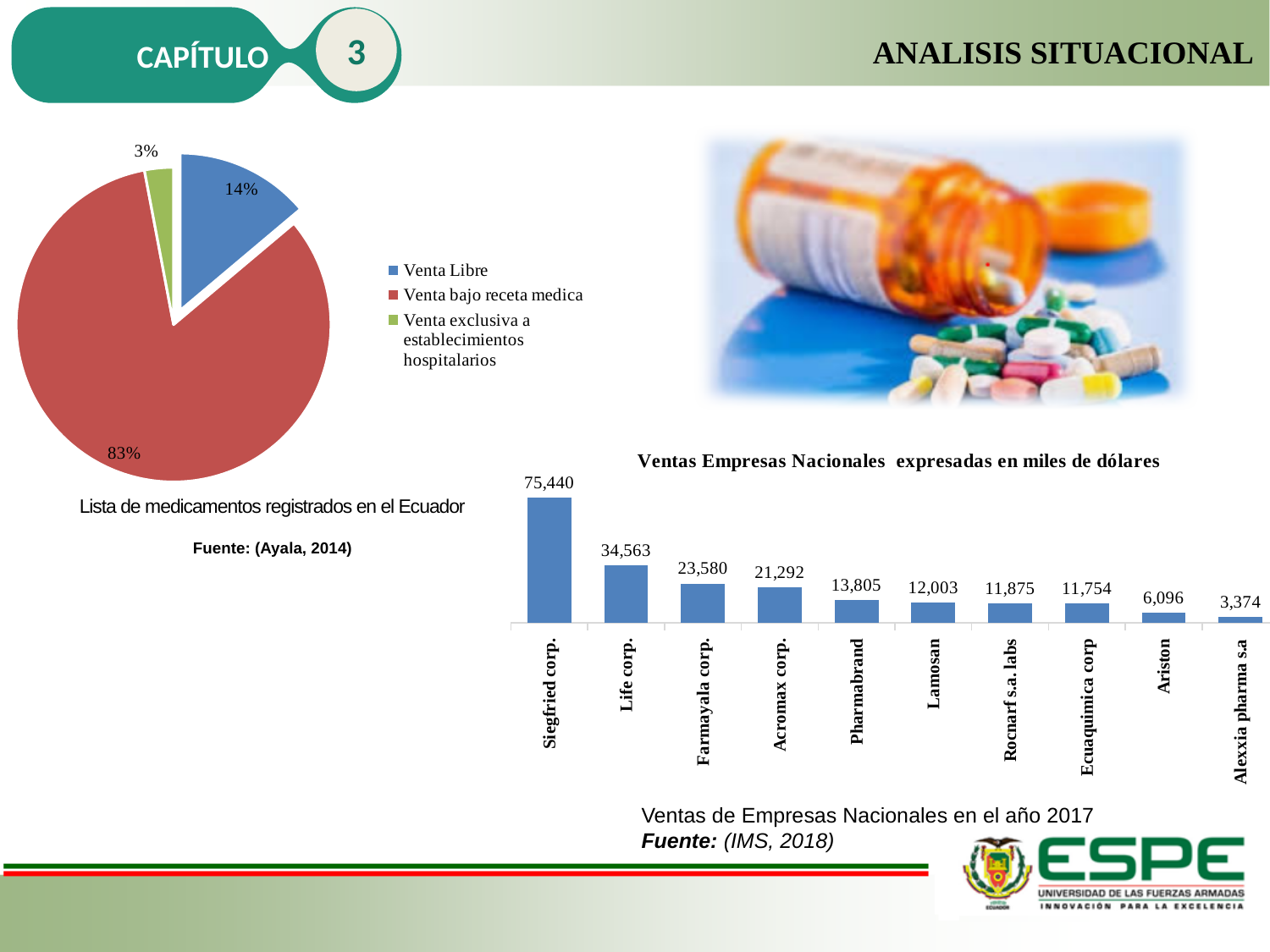
In the pie chart on the left, which category has the smallest slice? Venta exclusiva a establecimientos hospitalarios In the chart 'Ventas Empresas Nacionales expresadas en miles de dólares', which company has the lowest sales? Alexxia pharma s.a In the pie chart on the left, what is the difference in percentage points between 'Venta bajo receta medica' and 'Venta Libre'? 69 In the chart 'Ventas Empresas Nacionales expresadas en miles de dólares', what is the value for Life corp.? 34,563 In the pie chart on the left, what share does 'Venta Libre' have? 14% In the chart 'Ventas Empresas Nacionales expresadas en miles de dólares', how many companies are shown? 10 In the pie chart on the left, what share does 'Venta bajo receta medica' have? 83% What kind of chart is 'Ventas Empresas Nacionales expresadas en miles de dólares'? Bar chart In the pie chart on the left, how many categories does the legend list? 3 In the chart 'Ventas Empresas Nacionales expresadas en miles de dólares', which is larger, Farmayala corp. or Acromax corp.? Farmayala corp. In the chart 'Ventas Empresas Nacionales expresadas en miles de dólares', what is the difference between Siegfried corp. and Life corp.? 40,877 In the chart 'Ventas Empresas Nacionales expresadas en miles de dólares', which company has the highest sales? Siegfried corp.